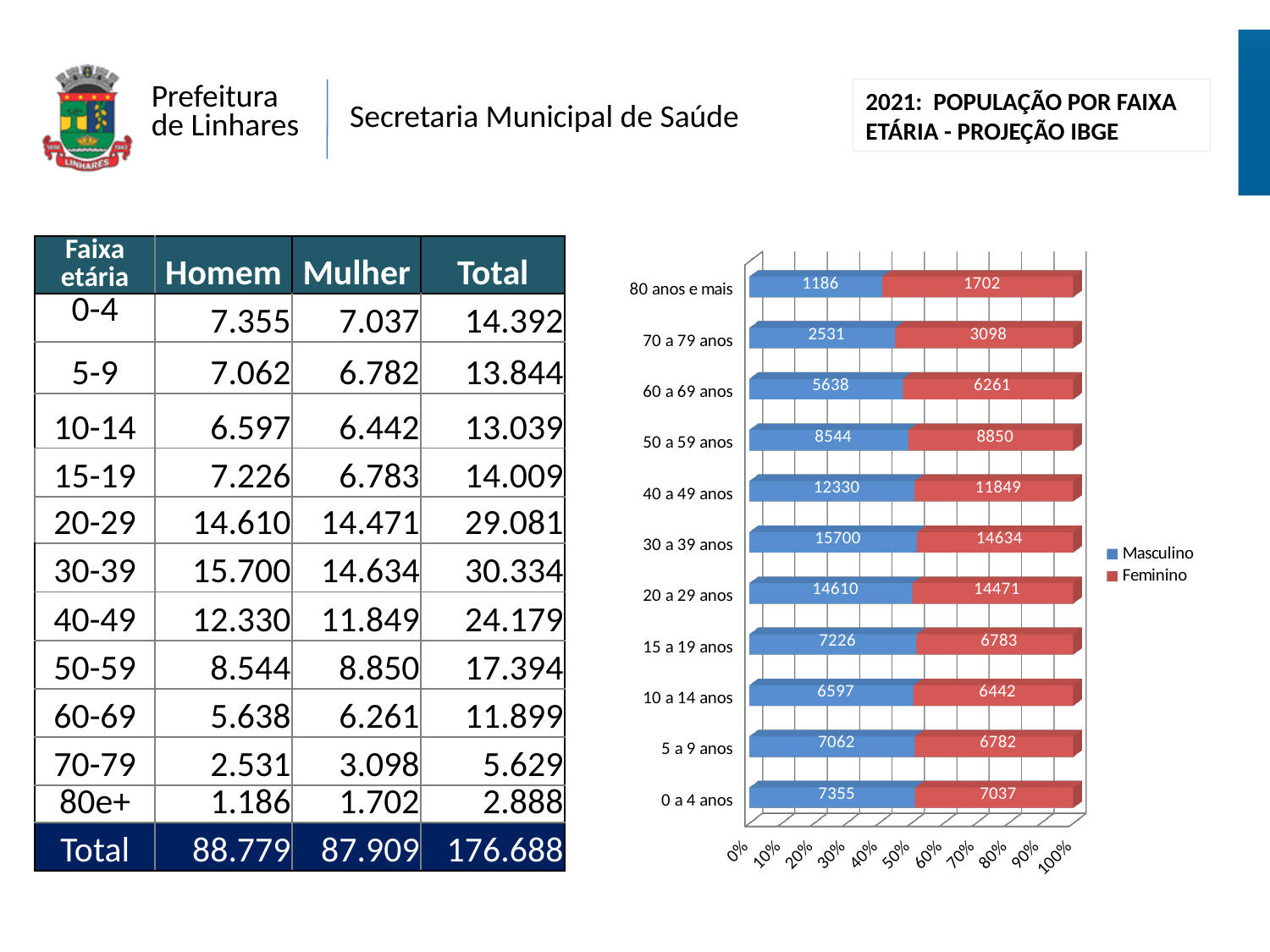
Which age category has the lowest Feminino value? 80 anos e mais Is the Masculino segment of the 80 anos e mais bar greater or less than 50%? less What is the Masculino value for the 30 a 39 anos category? 15700 Which age category has the highest Masculino value? 30 a 39 anos In the 50 a 59 anos category, which is larger, Masculino or Feminino? Feminino What is the Feminino value for the 80 anos e mais category? 1702 What is the combined Masculino and Feminino value for the 0 a 4 anos bar? 14392 How many series does the chart legend list? 2 How many age categories are shown in the chart? 11 What type of chart is shown on the slide? Stacked bar chart For the 40 a 49 anos category, how much larger is the Masculino value than the Feminino value? 481 For the 70 a 79 anos category, what is the difference between the Feminino and Masculino values? 567